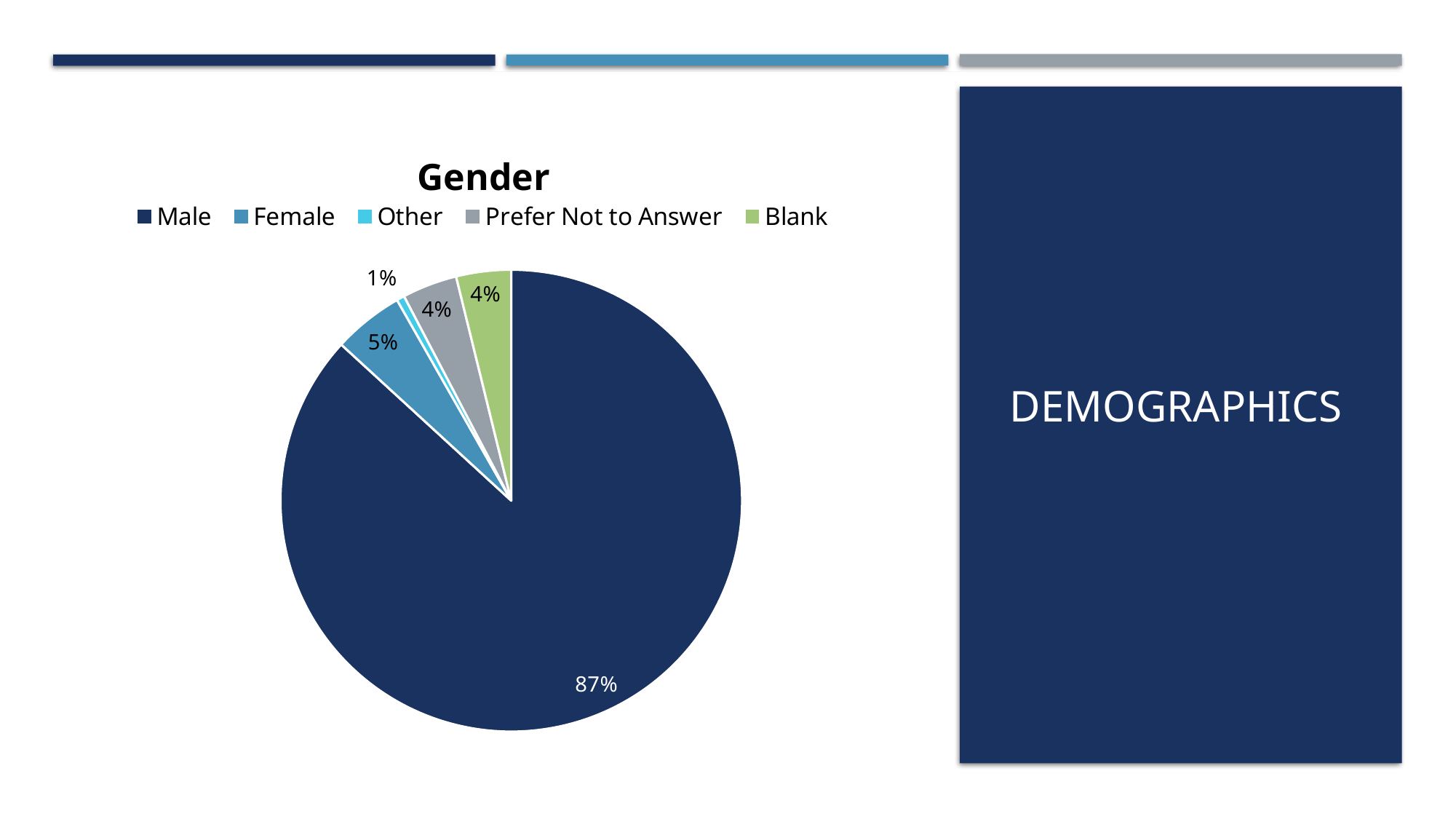
What percentage of the pie is Prefer Not to Answer? 4% Which is larger, the Female share or the Other share? Female How many categories does the legend list? 5 What is the title of the pie chart? Gender What type of chart is shown on the slide? Pie chart Which category has the largest share of the pie? Male What is the difference in percentage points between Male and Female? 82 What percentage of the pie is Other? 1% What percentage of the pie is Blank? 4% What percentage of the pie is Male? 87% What percentage of the pie is Female? 5% Which category has the smallest share of the pie? Other